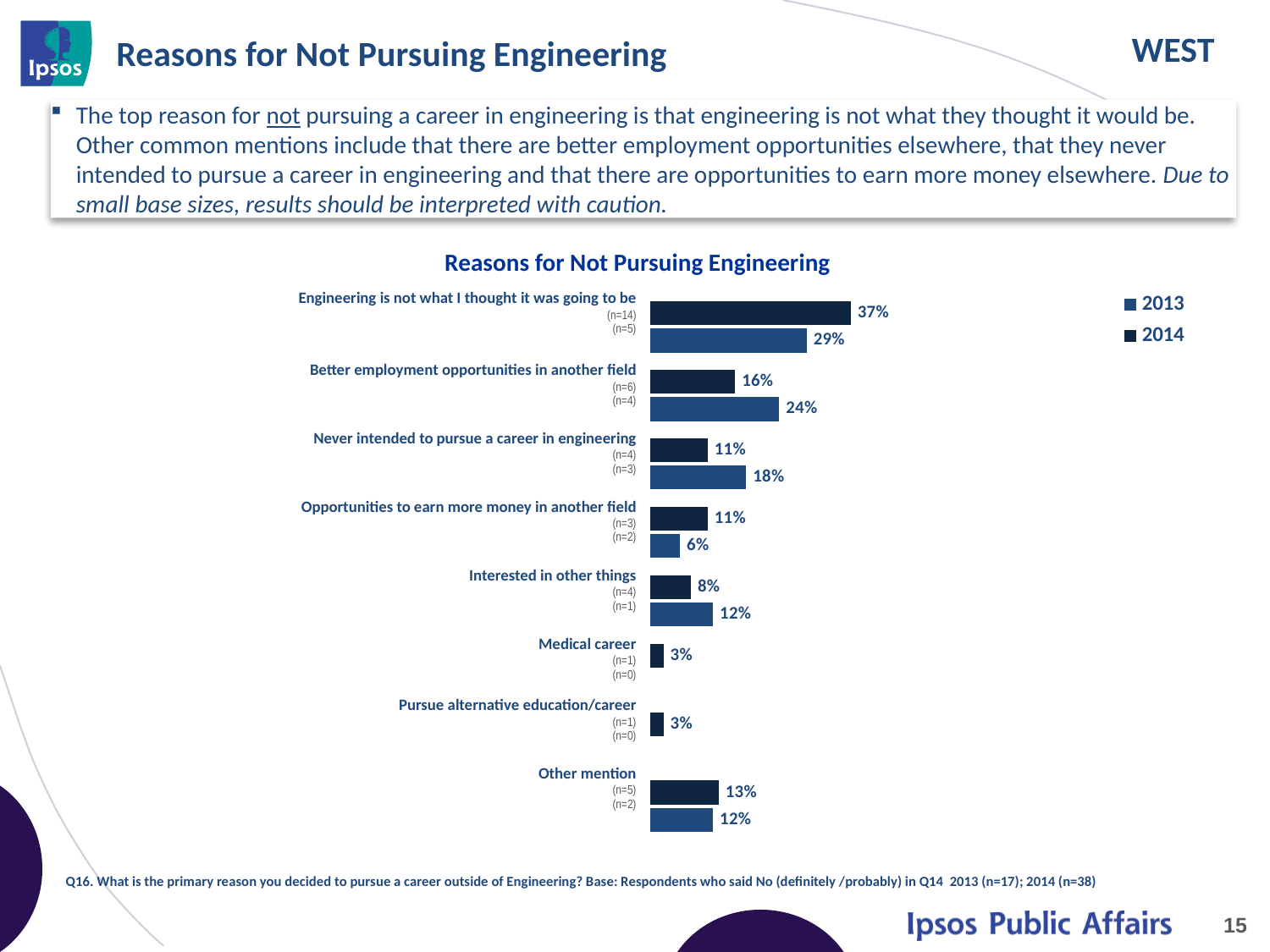
What is the value of the lighter blue bar for 'Never intended to pursue a career in engineering'? 18% Which reason has the highest value shown in the chart? Engineering is not what I thought it was going to be What is the difference between the two bars for 'Opportunities to earn more money in another field'? 5 percentage points What is the value of the dark navy bar for 'Other mention'? 13% What is the difference between the two bars for 'Engineering is not what I thought it was going to be'? 8 percentage points How many series does the chart legend list? 2 How many reason categories are plotted in the chart? 8 What is the value shown for 'Medical career'? 3% What kind of chart is shown on the slide? Bar chart For 'Interested in other things', which bar is larger, the dark navy bar or the lighter blue bar? The lighter blue bar What are the two entries in the chart legend? 2013 and 2014 What is the value of the dark navy bar for 'Better employment opportunities in another field'? 16%